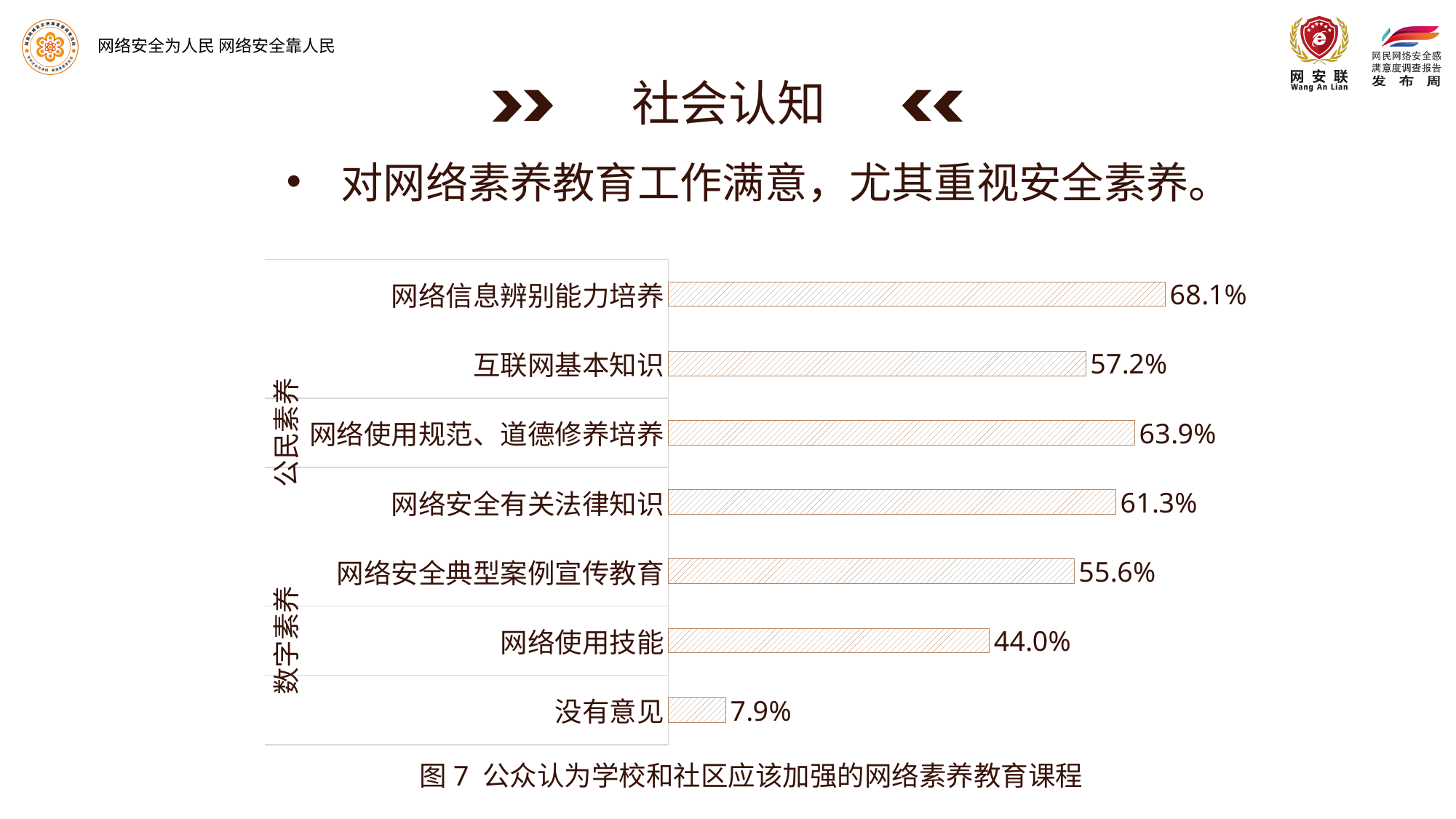
What is the difference between 网络使用规范、道德修养培养 and 网络安全有关法律知识? 2.6% Which category has the lowest value? 没有意见 Which category has the highest value? 网络信息辨别能力培养 What kind of chart is this? bar chart What is the difference between 网络信息辨别能力培养 and 互联网基本知识? 10.9% Which is larger, 互联网基本知识 or 网络安全典型案例宣传教育? 互联网基本知识 What is the value for 网络信息辨别能力培养? 68.1% What is the caption of the chart? 图 7 公众认为学校和社区应该加强的网络素养教育课程 Which two groups are the categories divided into on the left side of the chart? 公民素养 and 数字素养 How many categories are shown in the chart? 7 What is the value for 网络使用技能? 44.0% What is the value for 网络安全典型案例宣传教育? 55.6%